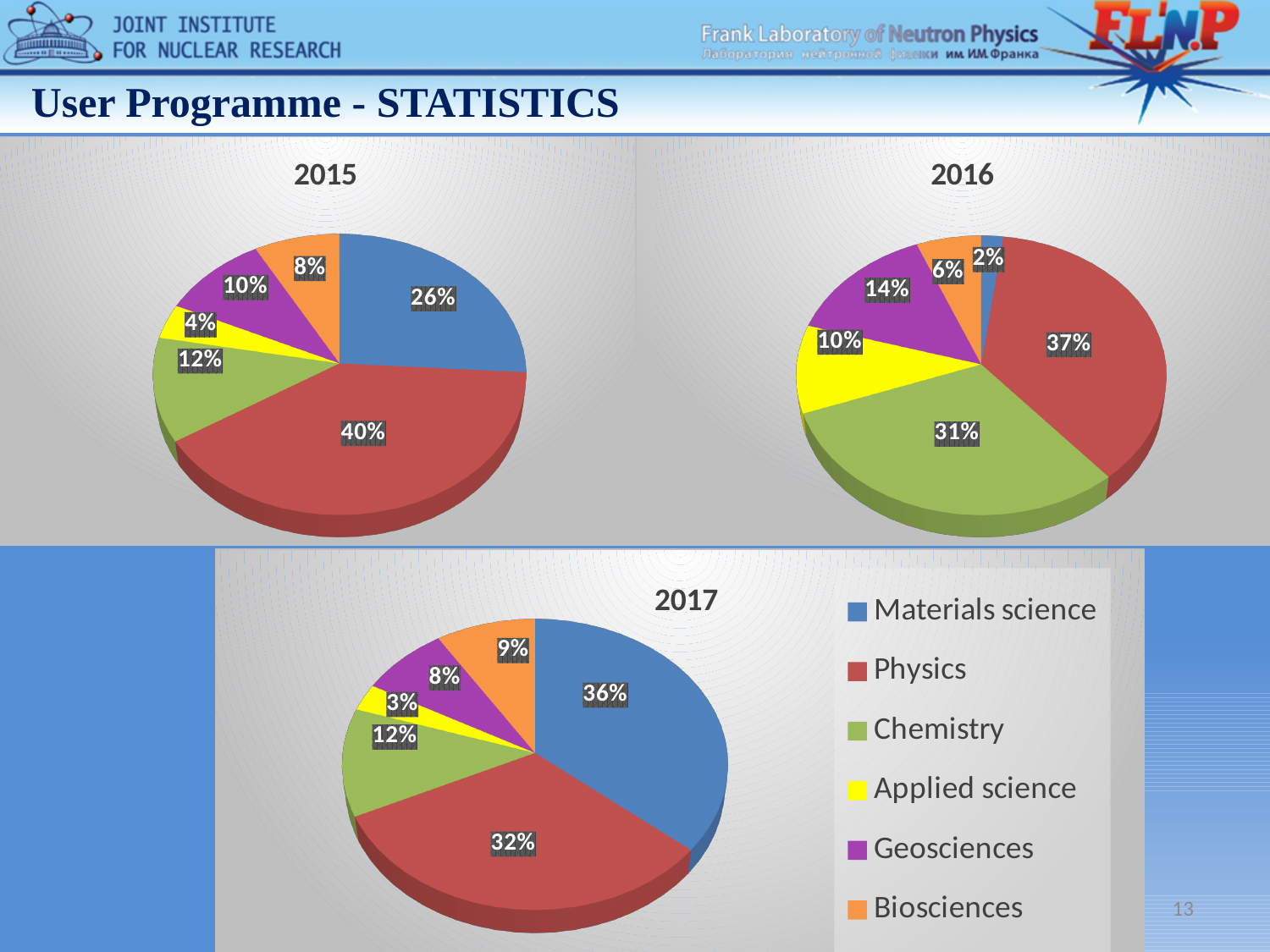
Which colour represents Biosciences in the legend? Orange In the 2017 pie chart, which category has the largest share? Materials science In the 2015 pie chart, which category has the smallest share? Applied science In the 2015 pie chart, what is the difference between the Physics share and the Materials science share? 14% How many categories does the legend list? 6 In the 2017 pie chart, which is larger, the Physics share or the Chemistry share? Physics In the 2017 pie chart, what share does Materials science have? 36% In the 2016 pie chart, what share does Geosciences have? 14% In the 2016 pie chart, what share does Chemistry have? 31% In the 2016 pie chart, which category has the smallest share? Materials science In the 2015 pie chart, what share does Physics have? 40% What kind of chart is used for the 2015, 2016 and 2017 data? Pie chart